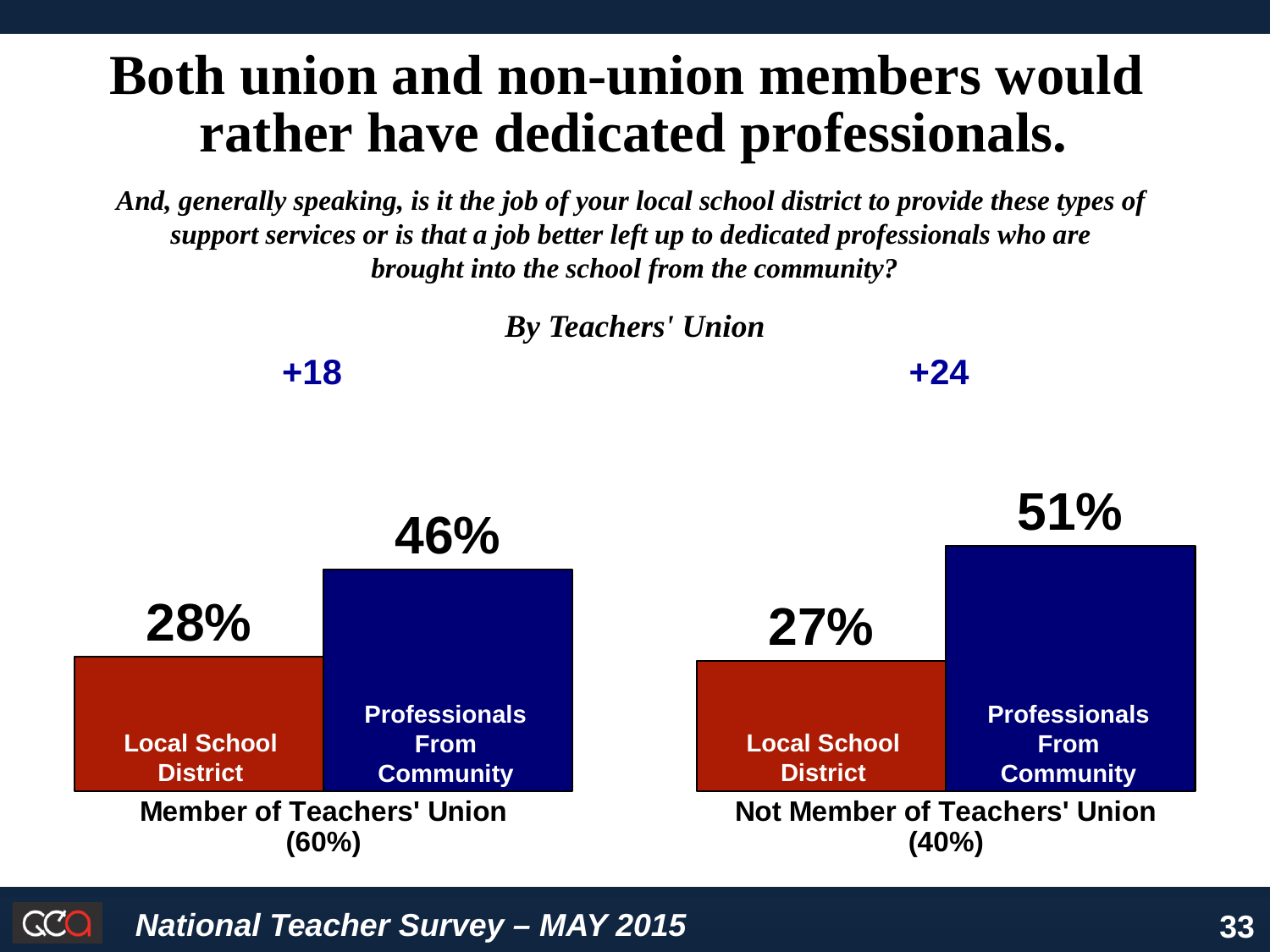
Which bar has the highest value on the chart? Professionals From Community (Not Member of Teachers' Union) Which bar has the lowest value on the chart? Local School District (Not Member of Teachers' Union) What percentage of members of the teachers' union chose Local School District? 28% What is the difference between Professionals From Community and Local School District among non-members of the teachers' union? 24 What percentage of members of the teachers' union chose Professionals From Community? 46% Among non-members of the teachers' union, which is larger: Local School District or Professionals From Community? Professionals From Community What kind of chart is shown on the slide? Bar chart How many groups of respondents are shown on the chart? 2 What percentage of non-members of the teachers' union chose Professionals From Community? 51% What percentage of non-members of the teachers' union chose Local School District? 27% What is the difference between Professionals From Community and Local School District among members of the teachers' union? 18 What colour are the Local School District bars? Red